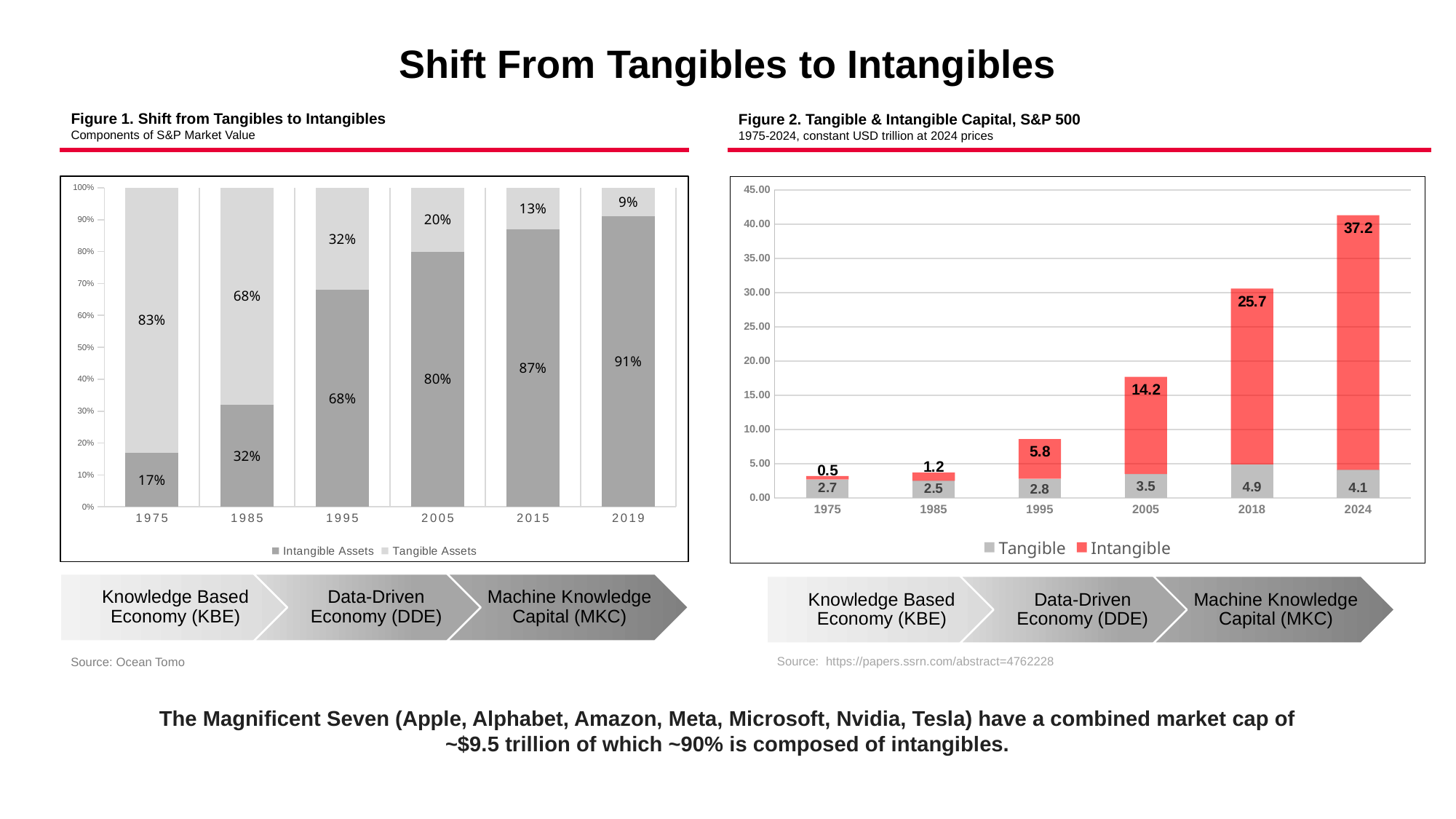
In Figure 2, what is the Intangible value for 2024? 37.2 In Figure 2, what is the Tangible value for 2018? 4.9 In Figure 2, what is the total of the stacked bar for 2024? 41.3 In Figure 1, how many years are shown on the x axis? 6 In Figure 1, what is the difference between the Intangible Assets share in 2005 and in 1985? 48 percentage points In Figure 2, which year has the lowest Intangible value? 1975 In Figure 2, how many series does the legend list? 2 In Figure 1, which year has the highest share of Intangible Assets? 2019 In Figure 1, how does the share of Intangible Assets change from 1975 to 2019? It rises In Figure 1, what percentage of S&P market value was Tangible Assets in 2019? 9% In Figure 1, what percentage of S&P market value was Intangible Assets in 1975? 17% In Figure 2, is the Tangible value larger in 2018 or in 2024? 2018